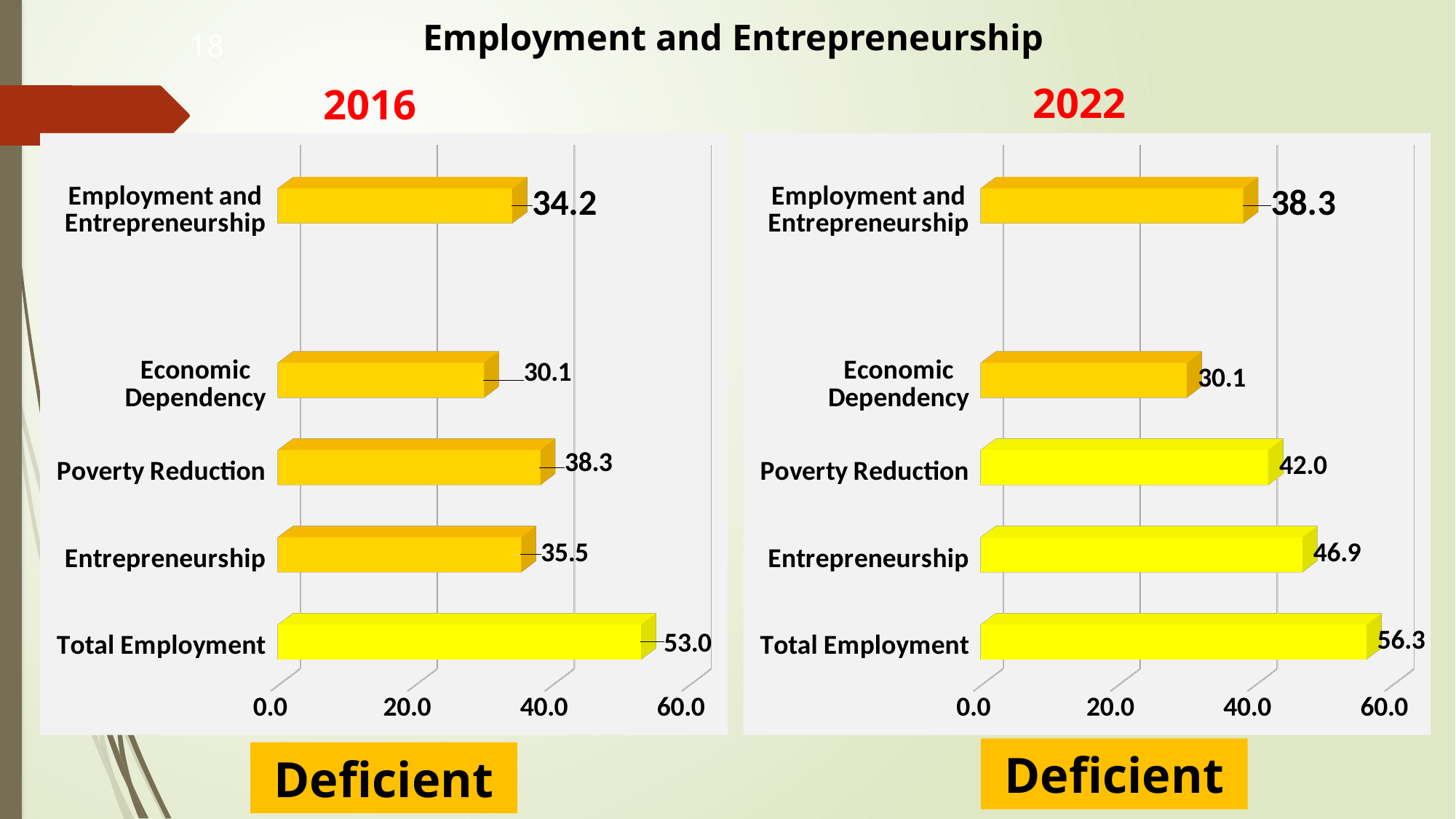
In the 2016 chart, which category has the lowest value? Economic Dependency In the 2016 chart, which is larger, Poverty Reduction or Entrepreneurship? Poverty Reduction In the 2022 chart, which category has the highest value? Total Employment What kind of chart is the 2022 chart? bar chart In the 2022 chart, what is the difference between Total Employment and Economic Dependency? 26.2 In the 2022 chart, is the value for Entrepreneurship greater or less than 40.0? greater What is the difference between the Employment and Entrepreneurship value in the 2022 chart and in the 2016 chart? 4.1 In the 2022 chart, what is the value for Entrepreneurship? 46.9 In the 2016 chart, what is the value for Employment and Entrepreneurship? 34.2 In the 2022 chart, what is the value for Poverty Reduction? 42.0 In the 2016 chart, what is the value for Total Employment? 53.0 How many categories are shown in the 2016 chart? 5